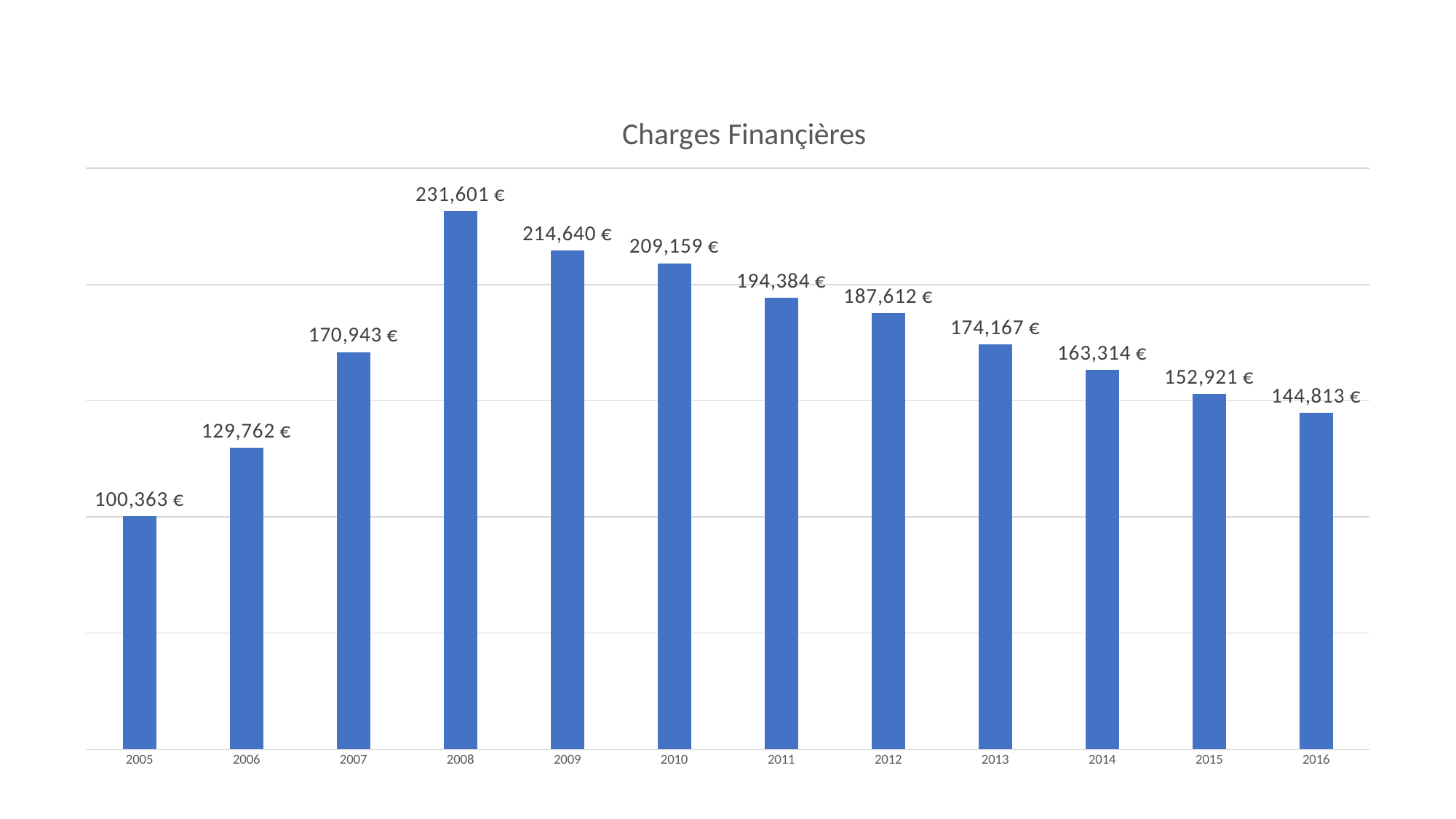
What is the difference between the values for 2008 and 2005? 131,238 € What is the value for 2008 in the Charges Finançières chart? 231,601 € How many years are shown on the x axis? 12 Do the values rise or fall from 2008 to 2016? Fall What is the value for 2005? 100,363 € What is the value for 2016? 144,813 € What is the difference between the values for 2007 and 2006? 41,181 € What kind of chart is shown on the slide? Bar chart What is the value for 2012? 187,612 € Which year has the highest value? 2008 Which is larger, the value for 2011 or the value for 2013? 2011 Which year has the lowest value? 2005